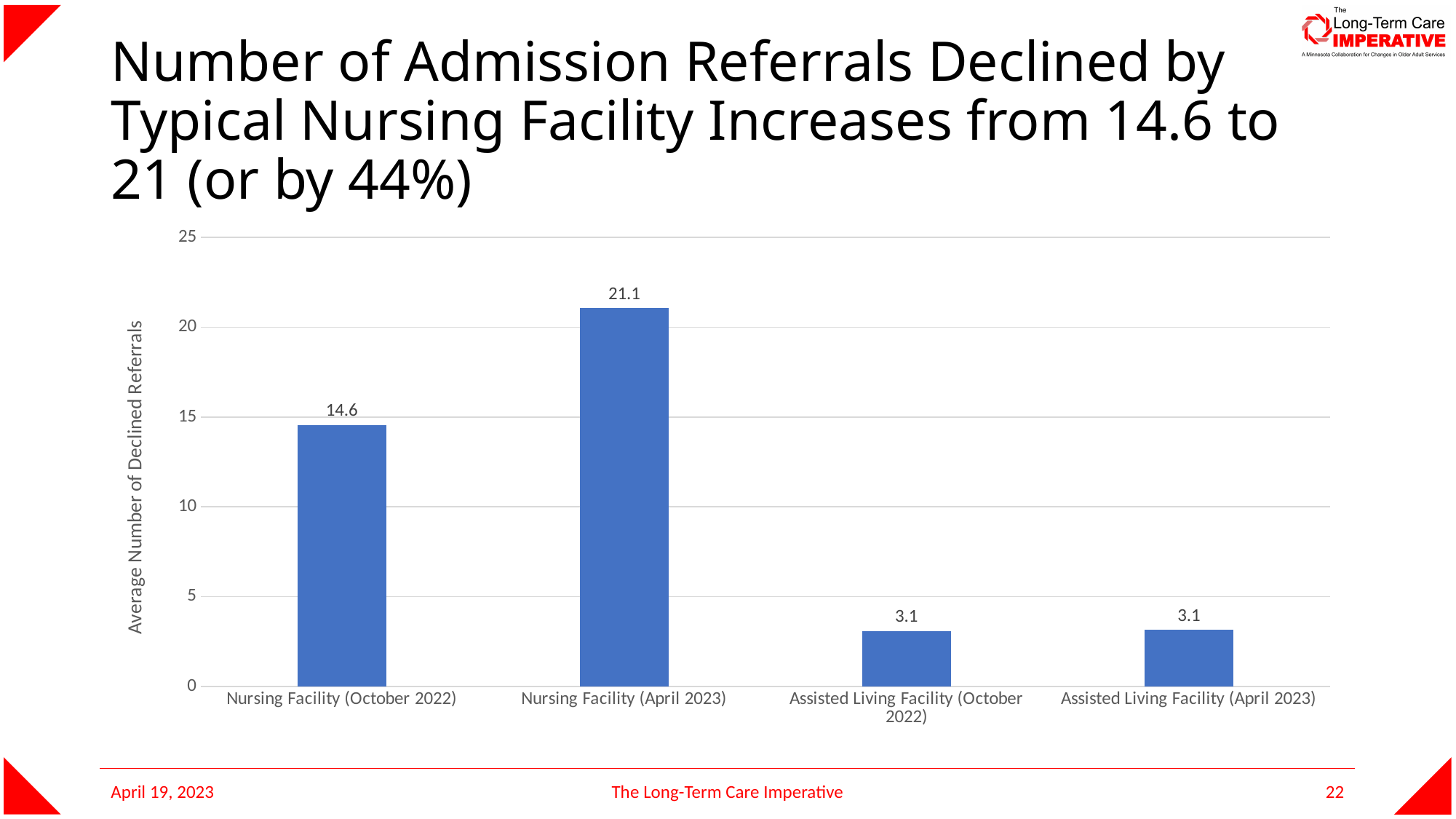
How many categories are shown on the x axis? 4 Which is larger, the value for Nursing Facility (October 2022) or the value for Assisted Living Facility (April 2023)? Nursing Facility (October 2022) What is the label of the vertical axis? Average Number of Declined Referrals What is the value for Nursing Facility (April 2023)? 21.1 What kind of chart is shown on the slide? bar chart What is the difference between the values for Nursing Facility (April 2023) and Nursing Facility (October 2022)? 6.5 Is the value for Assisted Living Facility (October 2022) greater or less than 5? less Is the value for Nursing Facility (April 2023) greater or less than 20? greater What is the value for Assisted Living Facility (October 2022)? 3.1 What is the value for Nursing Facility (October 2022)? 14.6 Which category has the highest value? Nursing Facility (April 2023) What is the difference between the values for Assisted Living Facility (April 2023) and Assisted Living Facility (October 2022)? 0